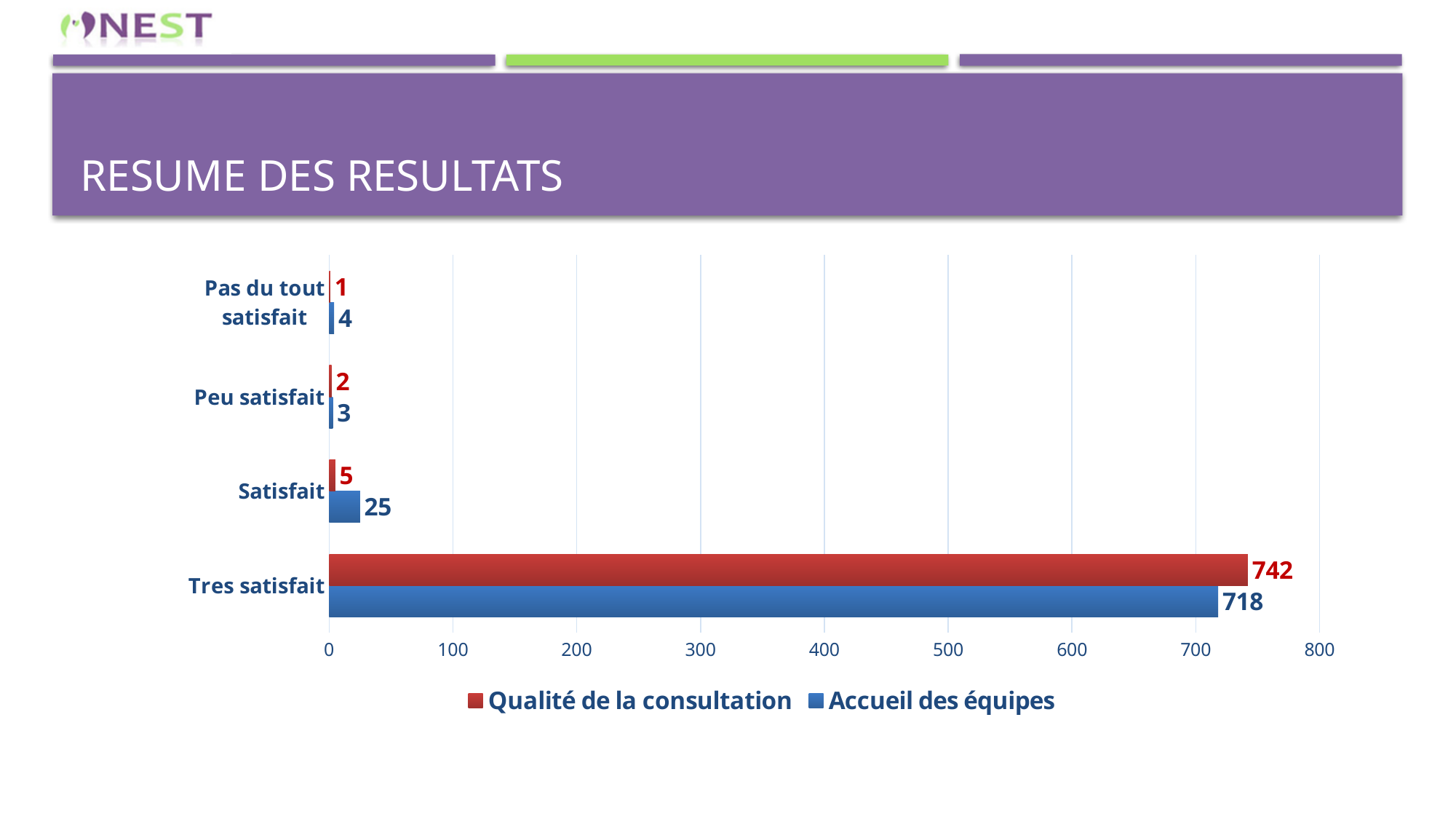
What is the value for 'Peu satisfait' in the 'Qualité de la consultation' series? 2 What is the value for 'Satisfait' in the 'Accueil des équipes' series? 25 What is the value for 'Pas du tout satisfait' in the 'Accueil des équipes' series? 4 What is the value for 'Tres satisfait' in the 'Accueil des équipes' series? 718 Which category has the lowest value in the 'Qualité de la consultation' series? Pas du tout satisfait What is the value for 'Tres satisfait' in the 'Qualité de la consultation' series? 742 Which category has the highest value in the 'Accueil des équipes' series? Tres satisfait For 'Satisfait', which series has the larger value: 'Qualité de la consultation' or 'Accueil des équipes'? Accueil des équipes What is the difference between the 'Qualité de la consultation' and 'Accueil des équipes' values for 'Tres satisfait'? 24 How many series does the legend list? 2 What kind of chart is shown on the slide? Bar chart How many categories are shown on the chart? 4